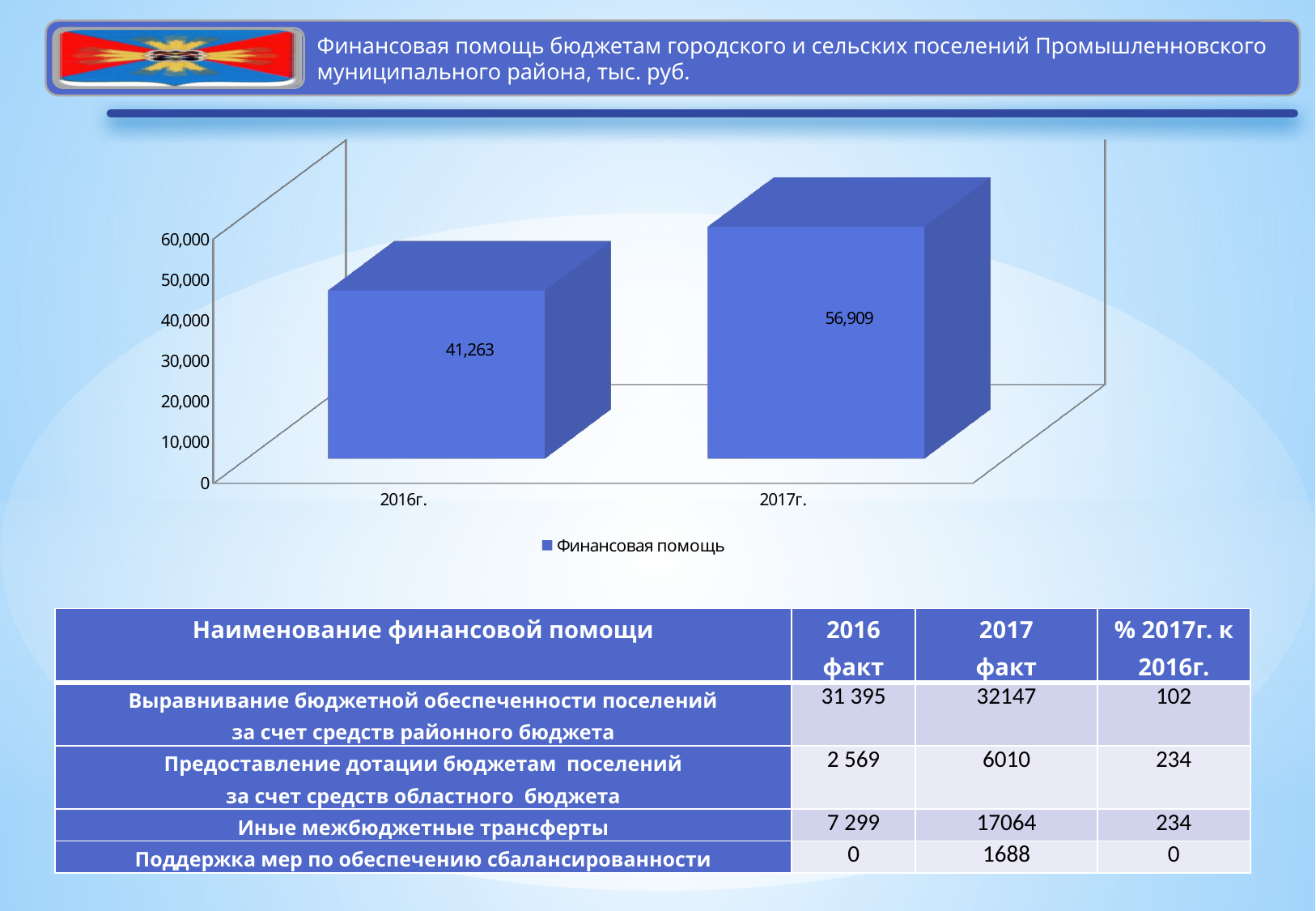
How many series does the chart legend list? 1 What is the difference between the 2017г. and 2016г. values of Финансовая помощь? 15,646 Does the value of Финансовая помощь rise or fall from 2016г. to 2017г.? Rise Is the value for 2016г. greater or less than 50,000? less What is the value of Финансовая помощь for 2017г.? 56,909 How many years (categories) are shown on the chart? 2 Is the value for 2017г. greater or less than 50,000? greater What type of chart is shown on the slide? Bar chart Which year has the lower value of Финансовая помощь? 2016г. Which year has the higher value of Финансовая помощь? 2017г. What is the value of Финансовая помощь for 2016г.? 41,263 Is the value for 2016г. larger or smaller than the value for 2017г.? smaller